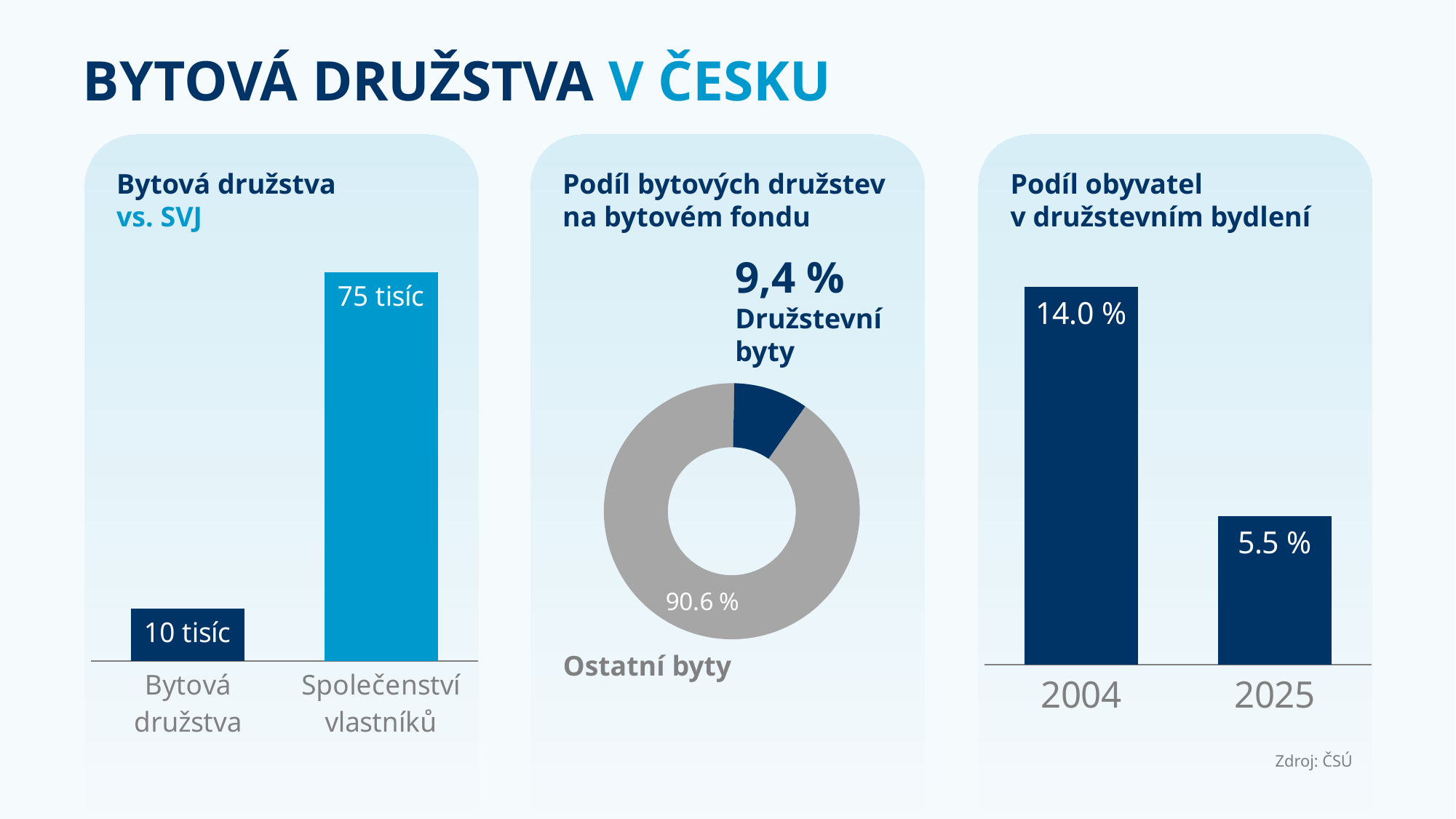
In the chart 'Podíl bytových družstev na bytovém fondu', what share do Ostatní byty have? 90.6 % What kind of chart is 'Bytová družstva vs. SVJ'? bar chart In the chart 'Podíl obyvatel v družstevním bydlení', what is the difference between the 2004 and 2025 values? 8.5 % In the chart 'Bytová družstva vs. SVJ', what is the difference between Společenství vlastníků and Bytová družstva? 65 tisíc In the chart 'Bytová družstva vs. SVJ', what is the value for Společenství vlastníků? 75 tisíc In the chart 'Bytová družstva vs. SVJ', which category has the higher value? Společenství vlastníků In the chart 'Podíl obyvatel v družstevním bydlení', what is the value for 2004? 14.0 % What kind of chart is 'Podíl bytových družstev na bytovém fondu'? donut chart In the chart 'Bytová družstva vs. SVJ', what is the value for Bytová družstva? 10 tisíc In the chart 'Podíl obyvatel v družstevním bydlení', what is the value for 2025? 5.5 % In the chart 'Podíl obyvatel v družstevním bydlení', do the values rise or fall from 2004 to 2025? fall In the chart 'Podíl bytových družstev na bytovém fondu', what share do Družstevní byty have? 9,4 %